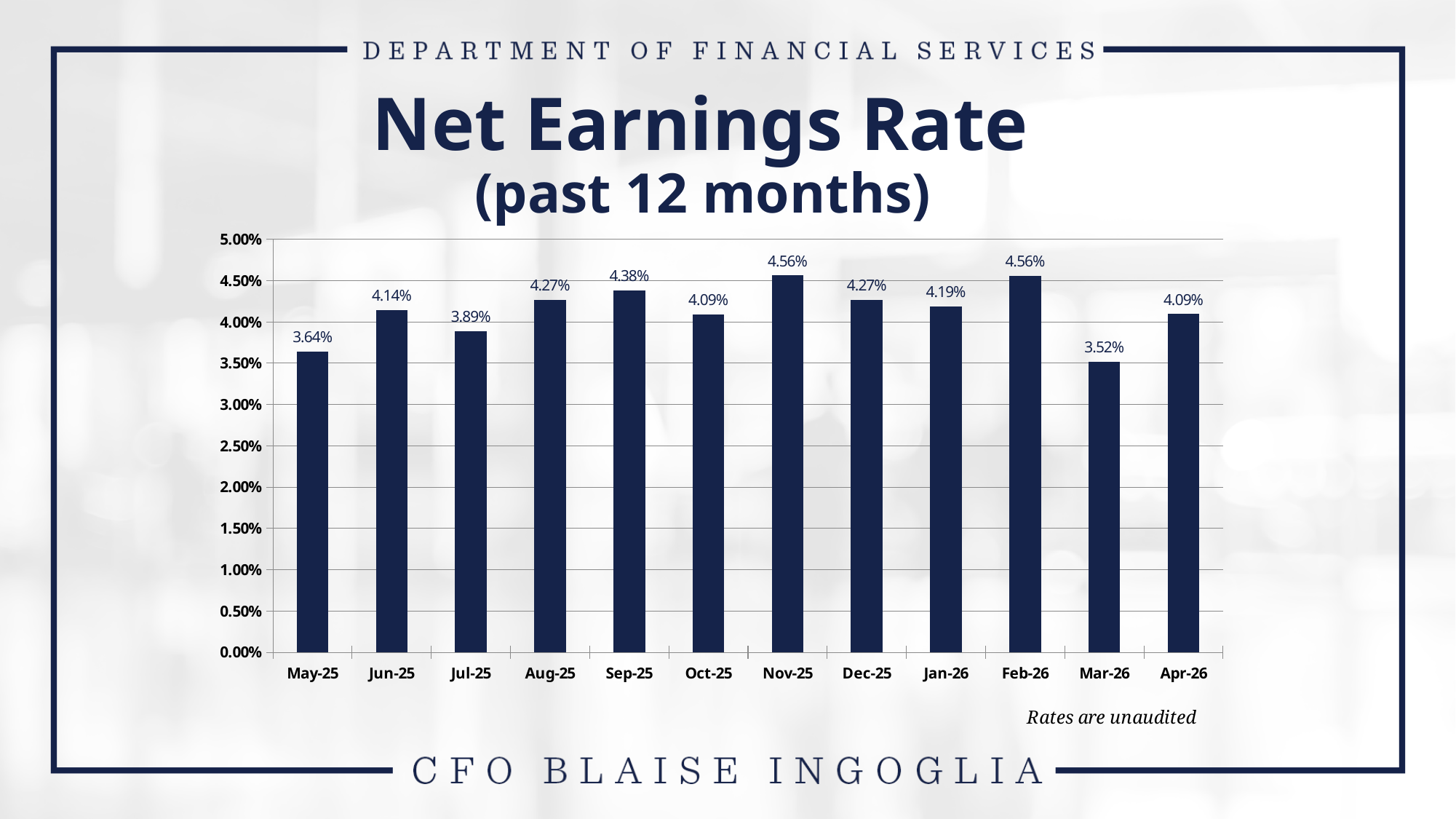
What is the net earnings rate for Nov-25? 4.56% What is the net earnings rate for Mar-26? 3.52% What is the net earnings rate for Sep-25? 4.38% What note appears below the chart about the rates? Rates are unaudited What is the difference between the net earnings rate in Feb-26 and Mar-26? 1.04% What kind of chart is shown on the slide? bar chart What is the difference between the net earnings rate in Apr-26 and May-25? 0.45% Does the net earnings rate rise or fall from Nov-25 to Jan-26? fall Which month has the lowest net earnings rate? Mar-26 Is the net earnings rate for May-25 greater or less than 4.00%? less How many months are shown on the chart? 12 Which is larger, the net earnings rate for Jun-25 or Jul-25? Jun-25